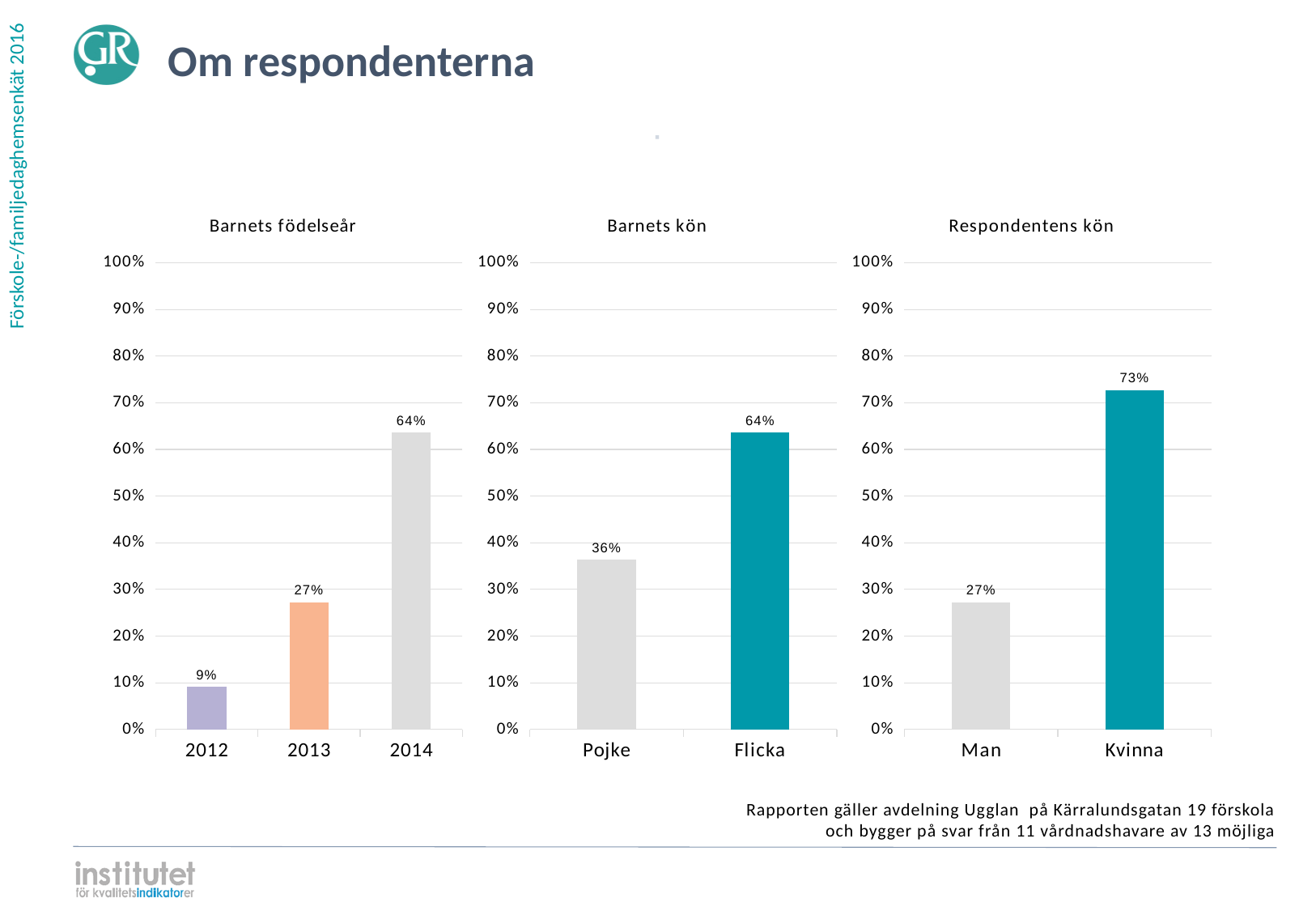
In the 'Respondentens kön' chart, what is the value for Kvinna? 73% In the 'Barnets kön' chart, which category has the highest value? Flicka What kind of chart is the 'Barnets födelseår' chart? Bar chart In the 'Barnets födelseår' chart, what is the difference between the values for 2014 and 2013? 37% In the 'Barnets födelseår' chart, how many categories are shown on the x axis? 3 In the 'Barnets födelseår' chart, what is the value for 2014? 64% In the 'Barnets födelseår' chart, what is the value for 2012? 9% In the 'Barnets kön' chart, what is the difference between Flicka and Pojke? 28% In the 'Barnets födelseår' chart, which year has the lowest value? 2012 In the 'Respondentens kön' chart, is the value for Man greater or less than 30%? less In the 'Barnets kön' chart, what is the value for Pojke? 36% In the 'Respondentens kön' chart, which is larger, Man or Kvinna? Kvinna